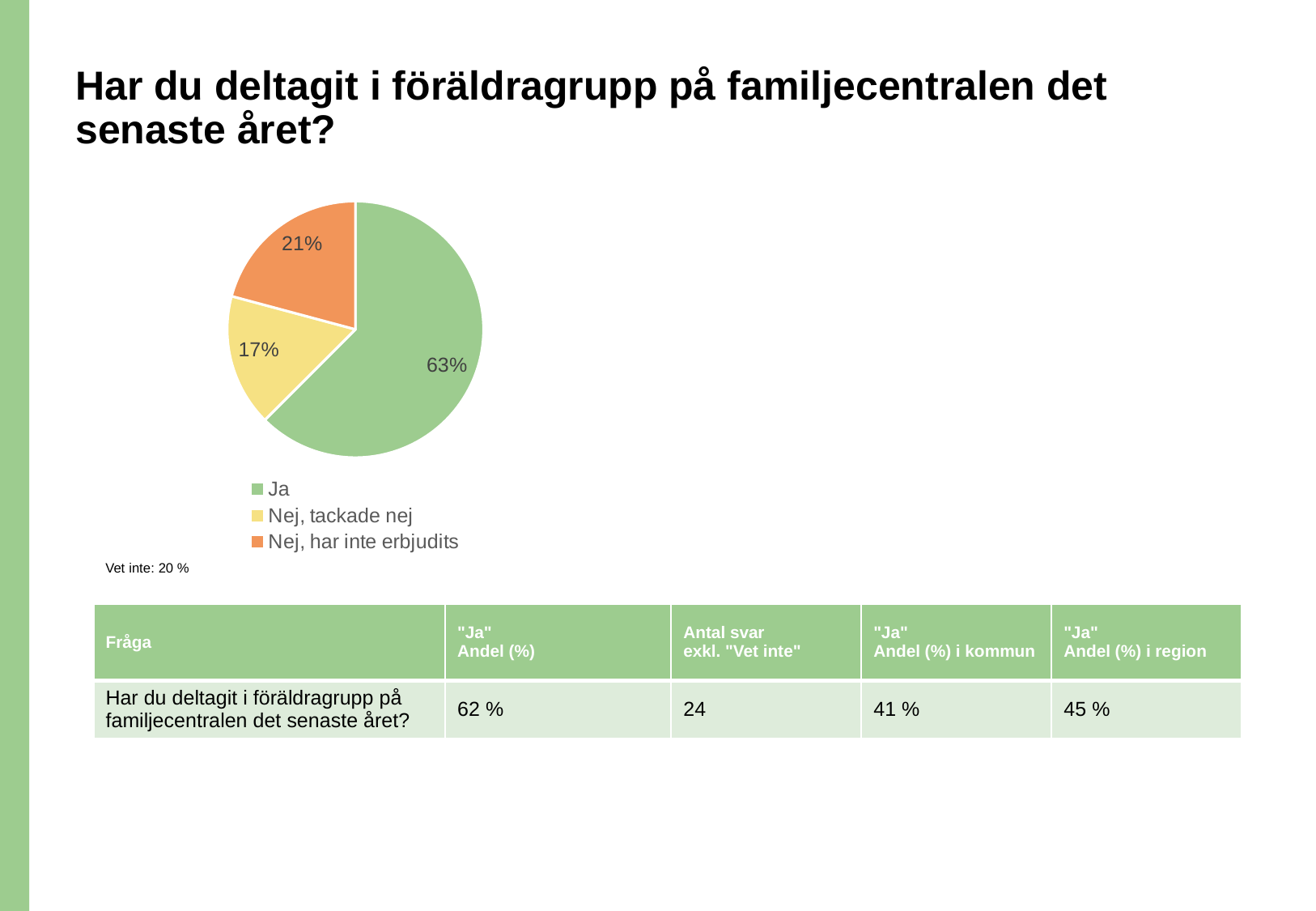
What share of the pie chart does the "Ja" slice represent? 63% What kind of chart is shown on the slide? Pie chart What share of the pie chart does the "Nej, tackade nej" slice represent? 17% Which category has the smallest slice in the pie chart? Nej, tackade nej What is the difference in percentage points between the "Ja" slice and the "Nej, har inte erbjudits" slice? 42 How many slices does the pie chart have? 3 Which slice is larger: "Nej, tackade nej" or "Nej, har inte erbjudits"? Nej, har inte erbjudits What share of the pie chart does the "Nej, har inte erbjudits" slice represent? 21% How many entries does the legend of the pie chart list? 3 What colour is the "Ja" slice in the pie chart? Green Which category has the largest slice in the pie chart? Ja What colour is the "Nej, har inte erbjudits" slice in the pie chart? Orange